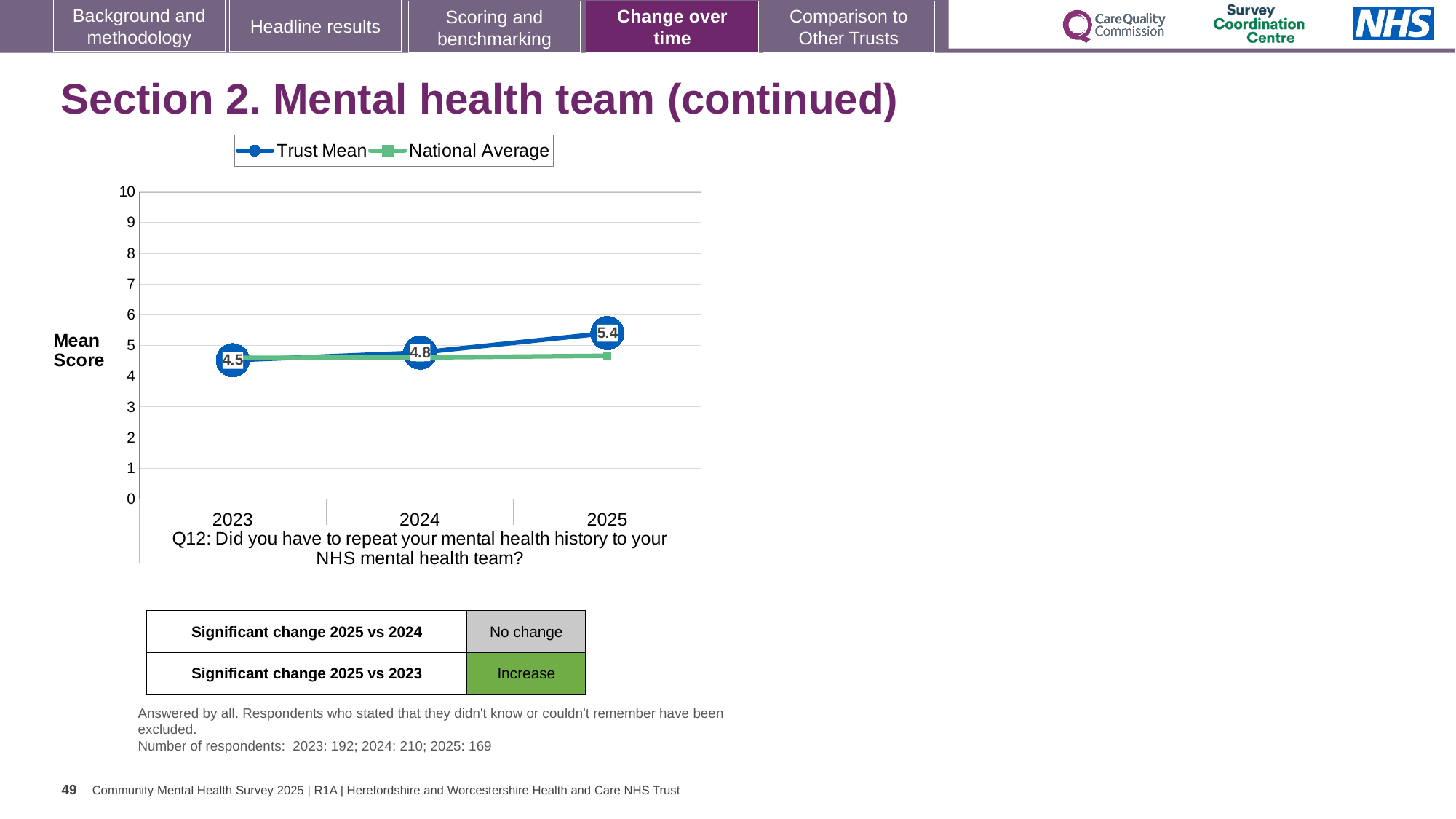
In 2025, which is larger, the Trust Mean or the National Average? Trust Mean In which year is the Trust Mean score highest? 2025 Is the National Average value for 2025 greater or less than 5? less How many series does the legend list? 2 In which year is the Trust Mean score lowest? 2023 What is the Trust Mean score for 2023? 4.5 Does the Trust Mean score rise or fall from 2023 to 2025? rise What is the difference between the Trust Mean score in 2025 and in 2024? 0.6 What is the Trust Mean score for 2025? 5.4 What is the Trust Mean score for 2024? 4.8 What type of chart is shown on the slide? line chart What is the difference between the Trust Mean score in 2025 and in 2023? 0.9